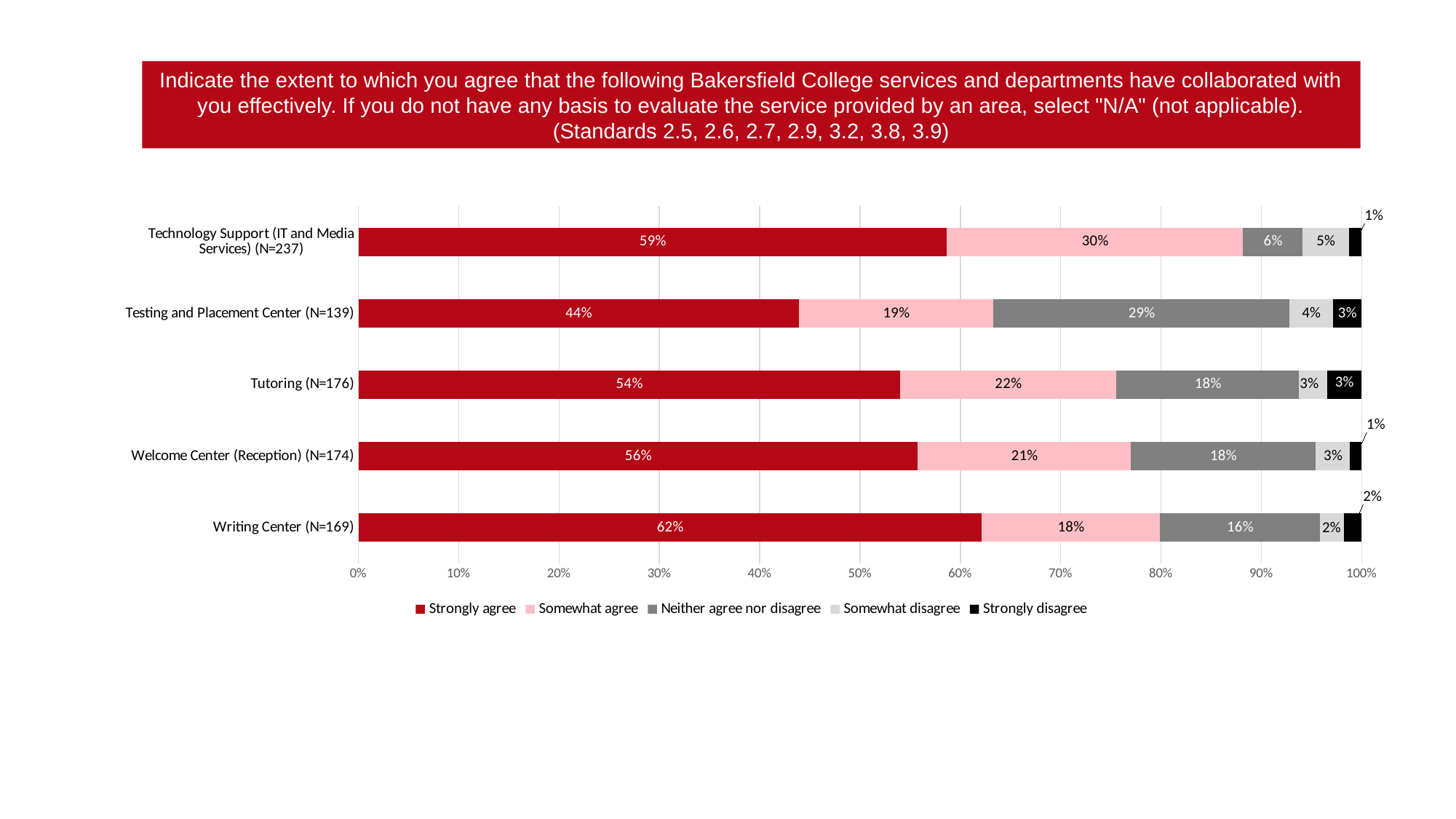
What percentage of respondents somewhat agree for Technology Support (IT and Media Services) (N=237)? 30% What kind of chart is shown on the slide? Stacked bar chart What is the combined percentage of Strongly agree and Somewhat agree for Technology Support (IT and Media Services) (N=237)? 89% How many services are shown in the chart? 5 Which service has the lowest Strongly agree percentage? Testing and Placement Center (N=139) Which service has the highest Strongly agree percentage? Writing Center (N=169) Which has a larger Somewhat agree percentage, Tutoring (N=176) or Welcome Center (Reception) (N=174)? Tutoring (N=176) What percentage of respondents neither agree nor disagree for Testing and Placement Center (N=139)? 29% What percentage of respondents strongly disagree for Tutoring (N=176)? 3% What percentage of respondents strongly agree for Writing Center (N=169)? 62% How many series does the legend list? 5 What is the difference in Strongly agree percentage between Writing Center (N=169) and Testing and Placement Center (N=139)? 18%